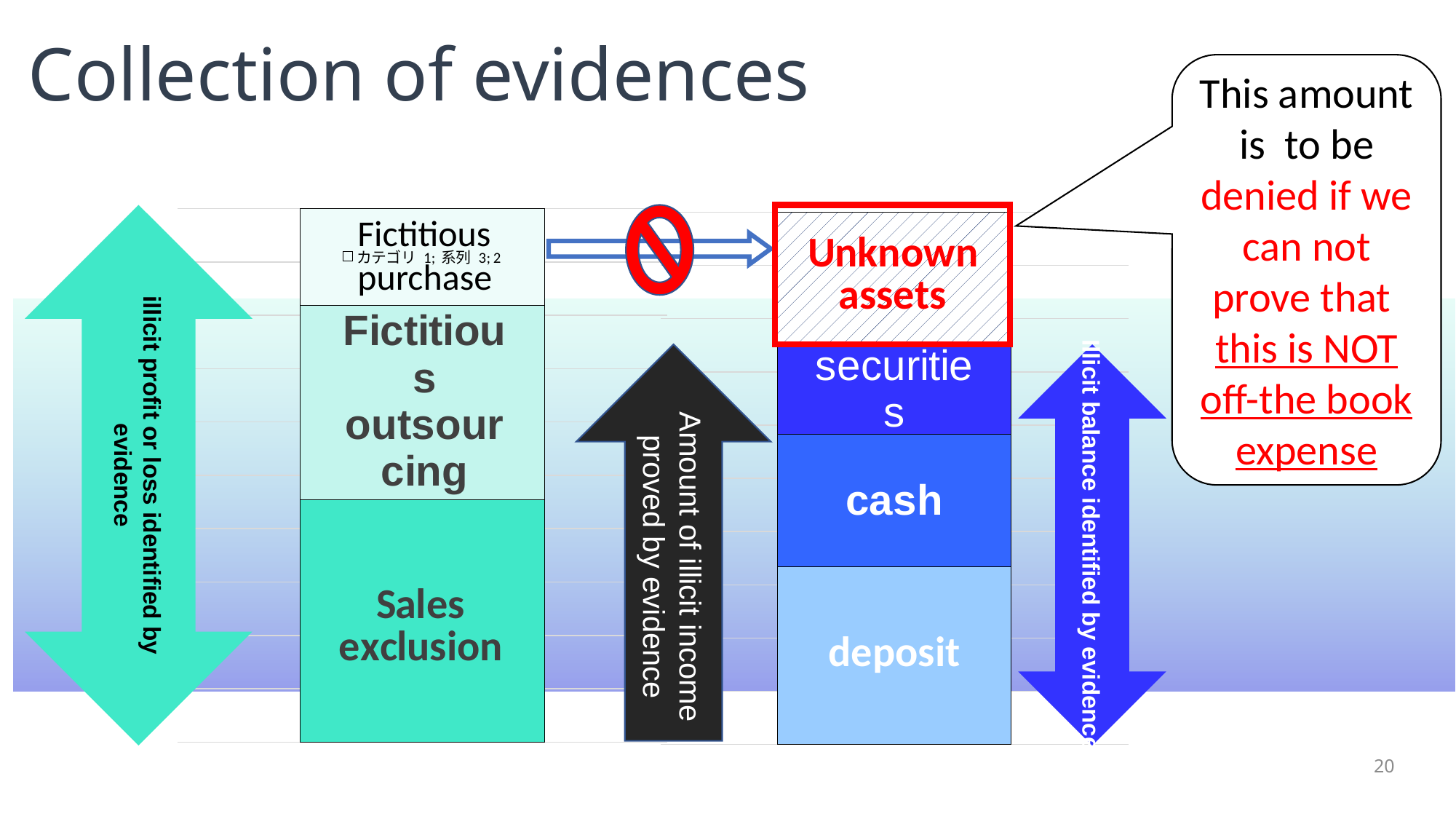
Which segment is the largest in the right stacked bar? deposit How many segments make up the right stacked bar? 4 Which is larger in the left bar, Sales exclusion or Fictitious outsourcing? Sales exclusion How many stacked bars does the chart contain? 2 Which segment sits at the top of the right stacked bar? Unknown assets What kind of chart is shown on the slide? stacked bar chart Which segment is the smallest in the left stacked bar? Fictitious purchase How many segments make up the left stacked bar? 3 Which segment is the largest in the left stacked bar? Sales exclusion Which is larger in the right bar, deposit or securities? deposit Which segment sits at the bottom of the left stacked bar? Sales exclusion